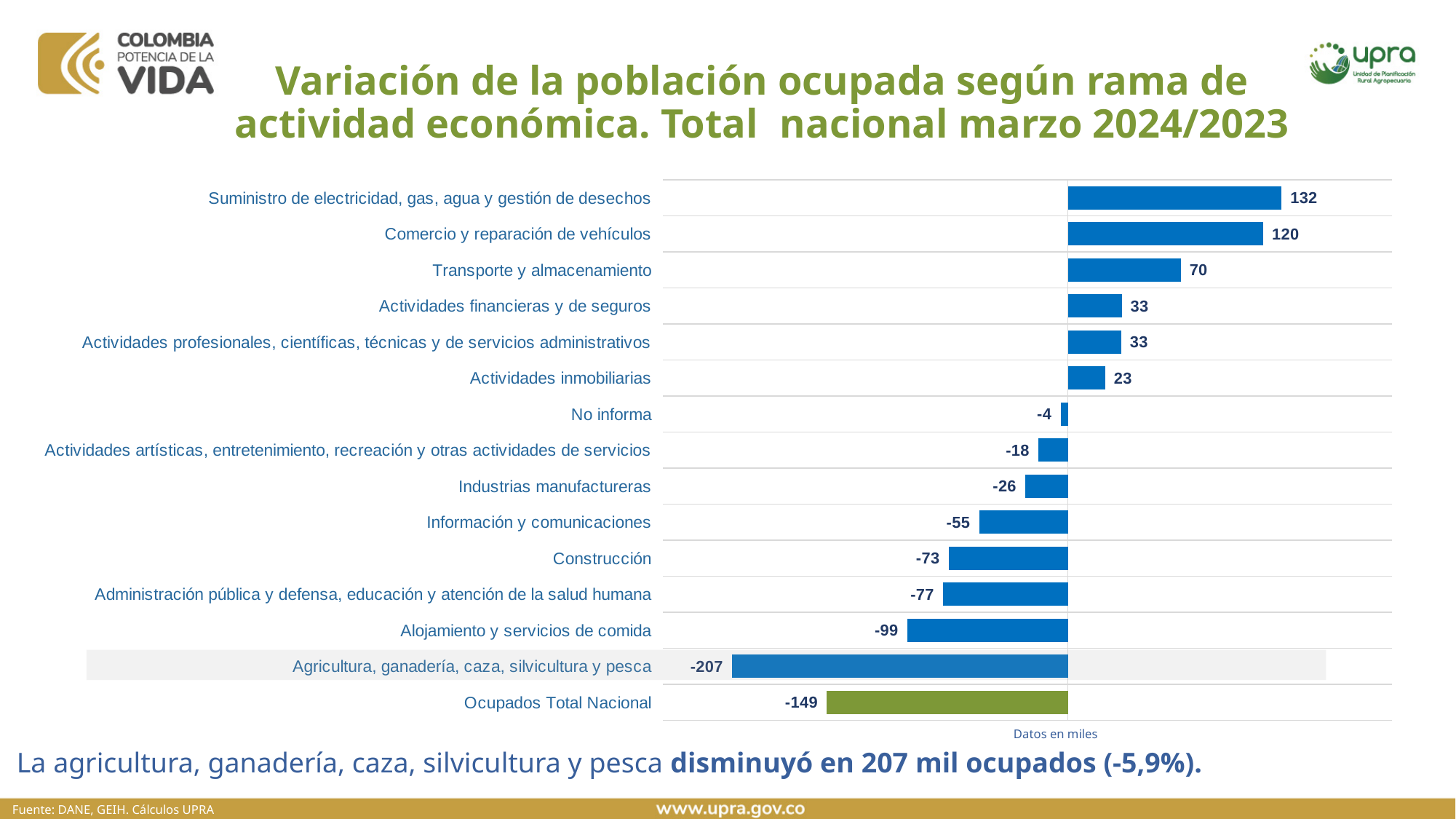
How many categories are shown in the chart? 15 Which category has the highest value? Suministro de electricidad, gas, agua y gestión de desechos What is the value for Ocupados Total Nacional? -149 What kind of chart is shown on the slide? Bar chart What is the difference between the values for Alojamiento y servicios de comida and Agricultura, ganadería, caza, silvicultura y pesca? 108 Which category has the lowest value? Agricultura, ganadería, caza, silvicultura y pesca In what units are the data in the chart expressed, according to the note below the chart? Datos en miles What is the value for Actividades inmobiliarias? 23 What is the value for Transporte y almacenamiento? 70 What is the difference between the values for Suministro de electricidad, gas, agua y gestión de desechos and Comercio y reparación de vehículos? 12 What is the value for Alojamiento y servicios de comida? -99 Which has the larger value, Construcción or Industrias manufactureras? Industrias manufactureras